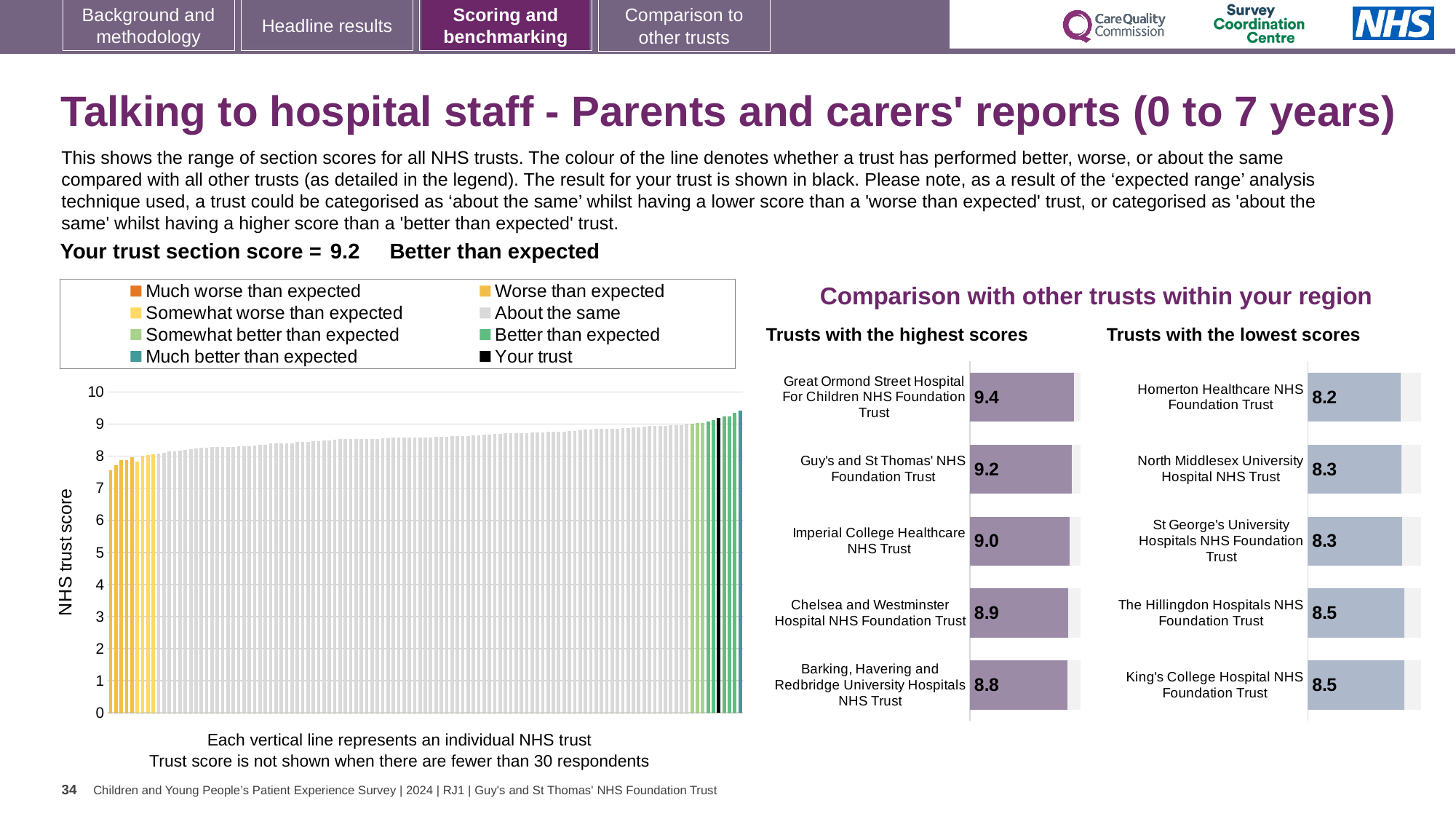
In the 'Trusts with the highest scores' chart, what is the score for Great Ormond Street Hospital For Children NHS Foundation Trust? 9.4 In the 'Trusts with the highest scores' chart, which has the higher score: Imperial College Healthcare NHS Trust or Chelsea and Westminster Hospital NHS Foundation Trust? Imperial College Healthcare NHS Trust In the left-hand chart of NHS trust scores, is the value of the black bar (your trust) greater or less than 8? greater How many entries does the legend of the left-hand NHS trust score chart list? 8 In the 'Trusts with the lowest scores' chart, what is the score for Homerton Healthcare NHS Foundation Trust? 8.2 What kind of chart is the large chart on the left showing NHS trust scores? bar chart In the 'Trusts with the lowest scores' chart, which trust has the lowest score? Homerton Healthcare NHS Foundation Trust In the 'Trusts with the lowest scores' chart, what is the difference between the scores of King's College Hospital NHS Foundation Trust and Homerton Healthcare NHS Foundation Trust? 0.3 In the 'Trusts with the lowest scores' chart, what is the score for The Hillingdon Hospitals NHS Foundation Trust? 8.5 In the 'Trusts with the highest scores' chart, what is the difference between the scores of Great Ormond Street Hospital For Children NHS Foundation Trust and Barking, Havering and Redbridge University Hospitals NHS Trust? 0.6 In the 'Trusts with the highest scores' chart, which trust has the highest score? Great Ormond Street Hospital For Children NHS Foundation Trust How many trusts are shown in the 'Trusts with the highest scores' chart? 5